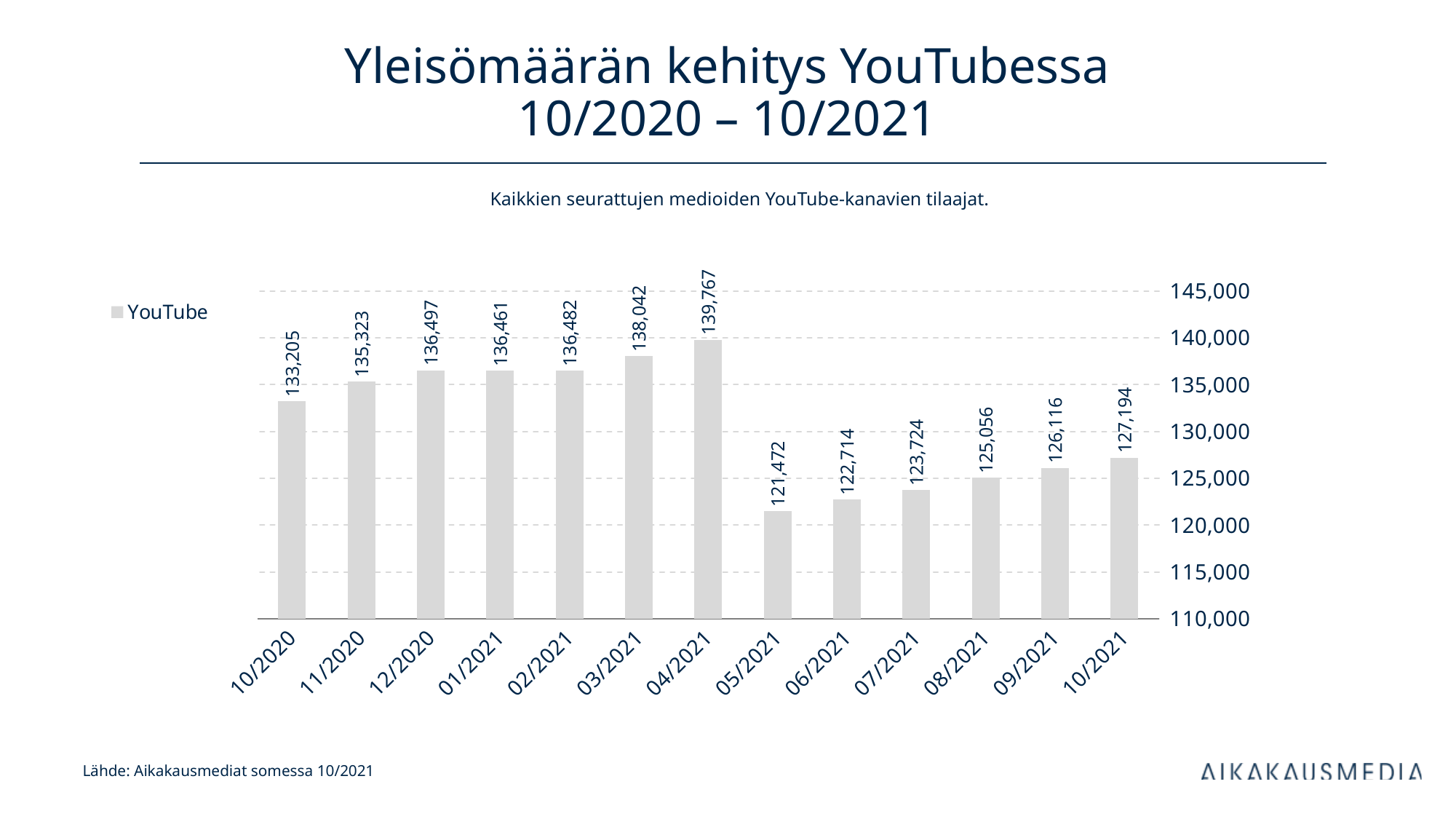
What is the difference between the values for 04/2021 and 05/2021? 18,295 What is the value for 05/2021? 121,472 How many series does the legend list? 1 Which is larger, the value for 03/2021 or the value for 10/2021? 03/2021 How many months are shown on the x axis? 13 Which month has the lowest value? 05/2021 Which month has the highest value? 04/2021 Is the value for 08/2021 greater or less than 130,000? less What kind of chart is shown? bar chart What is the value for 10/2020? 133,205 What is the value for 04/2021? 139,767 What is the name of the series in the legend? YouTube